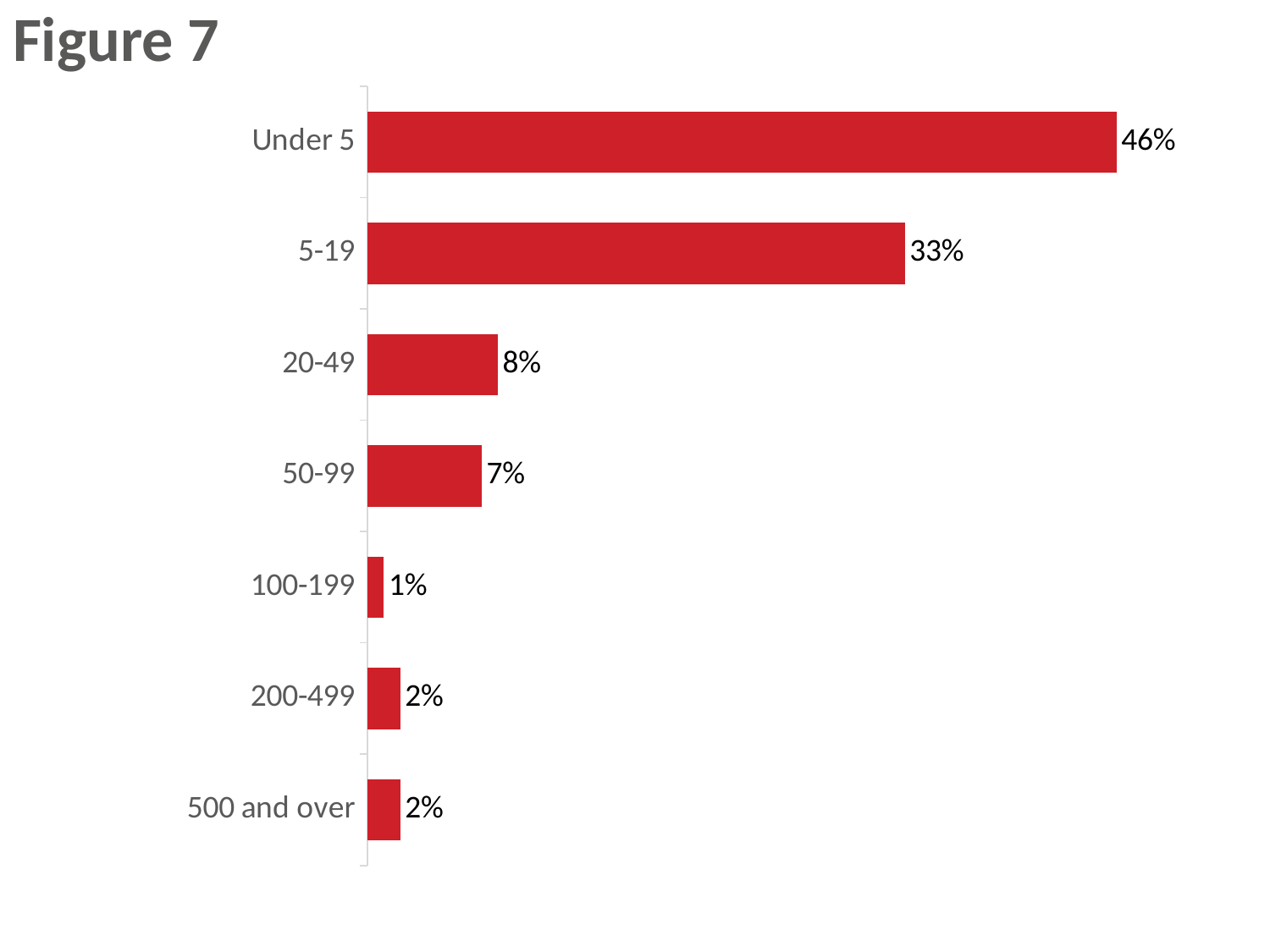
What is the value for the 100-199 category? 1% What is the difference between the values for 20-49 and 50-99? 1% Which category has the highest value? Under 5 What is the value for the 5-19 category? 33% Which category has the lowest value? 100-199 How many categories are shown in the chart? 7 What kind of chart is shown on the slide? Bar chart What is the title of the slide? Figure 7 Which is larger, the value for 20-49 or the value for 200-499? 20-49 What is the value for the Under 5 category? 46% What is the value for the 50-99 category? 7% What is the difference between the values for Under 5 and 5-19? 13%